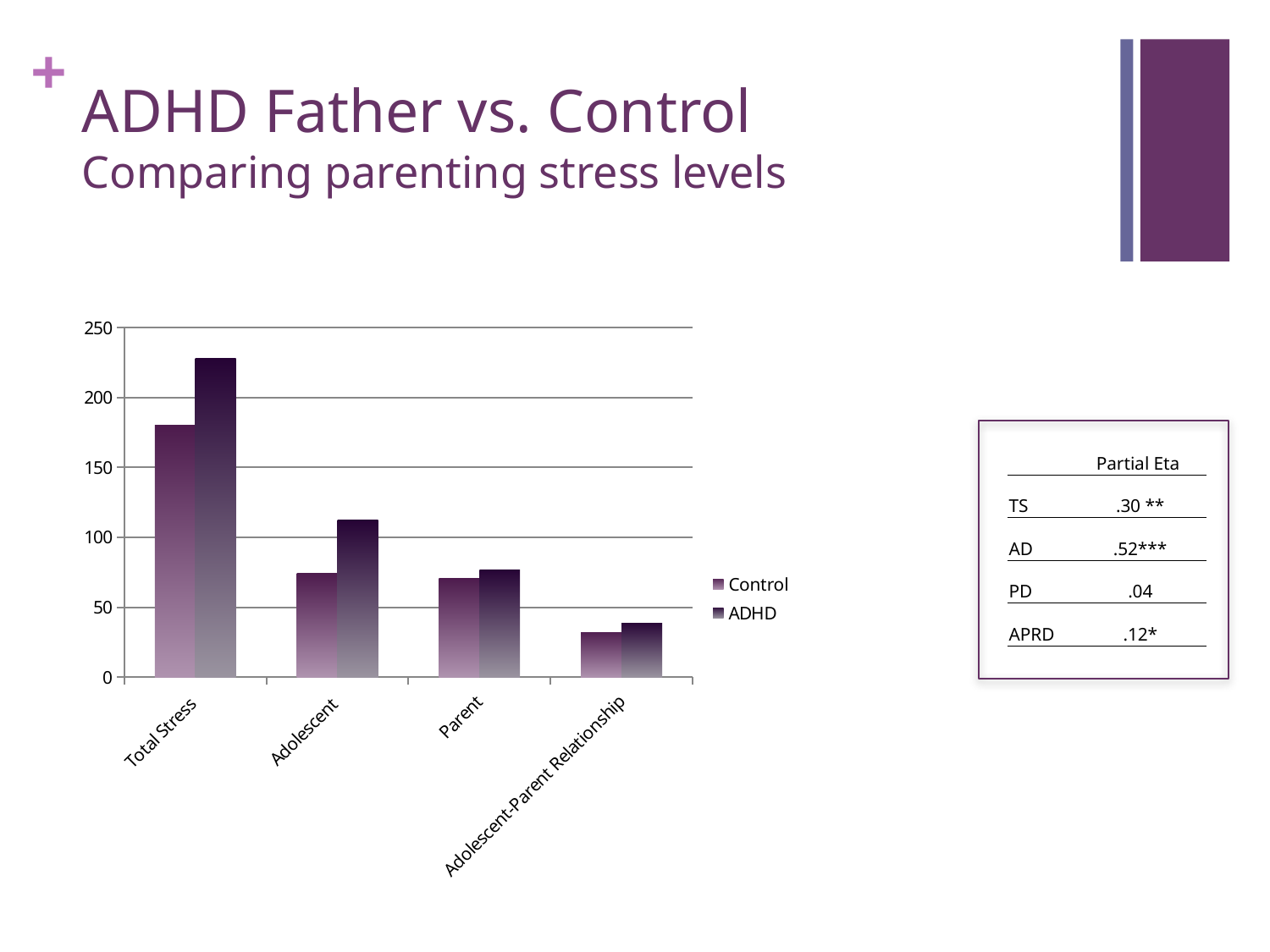
Is the Control value for Adolescent greater or less than 100? less For Total Stress, which series has the larger value, Control or ADHD? ADHD What kind of chart is shown on the slide? bar chart What are the two series named in the chart's legend? Control and ADHD Which category has the lowest Control value? Adolescent-Parent Relationship How many categories are shown on the x axis of the chart? 4 How many series does the chart's legend list? 2 Is the ADHD value for Total Stress greater or less than 200? greater Is the ADHD value for Adolescent greater or less than 100? greater Which category has the highest ADHD value? Total Stress For Adolescent, which series has the larger value, Control or ADHD? ADHD